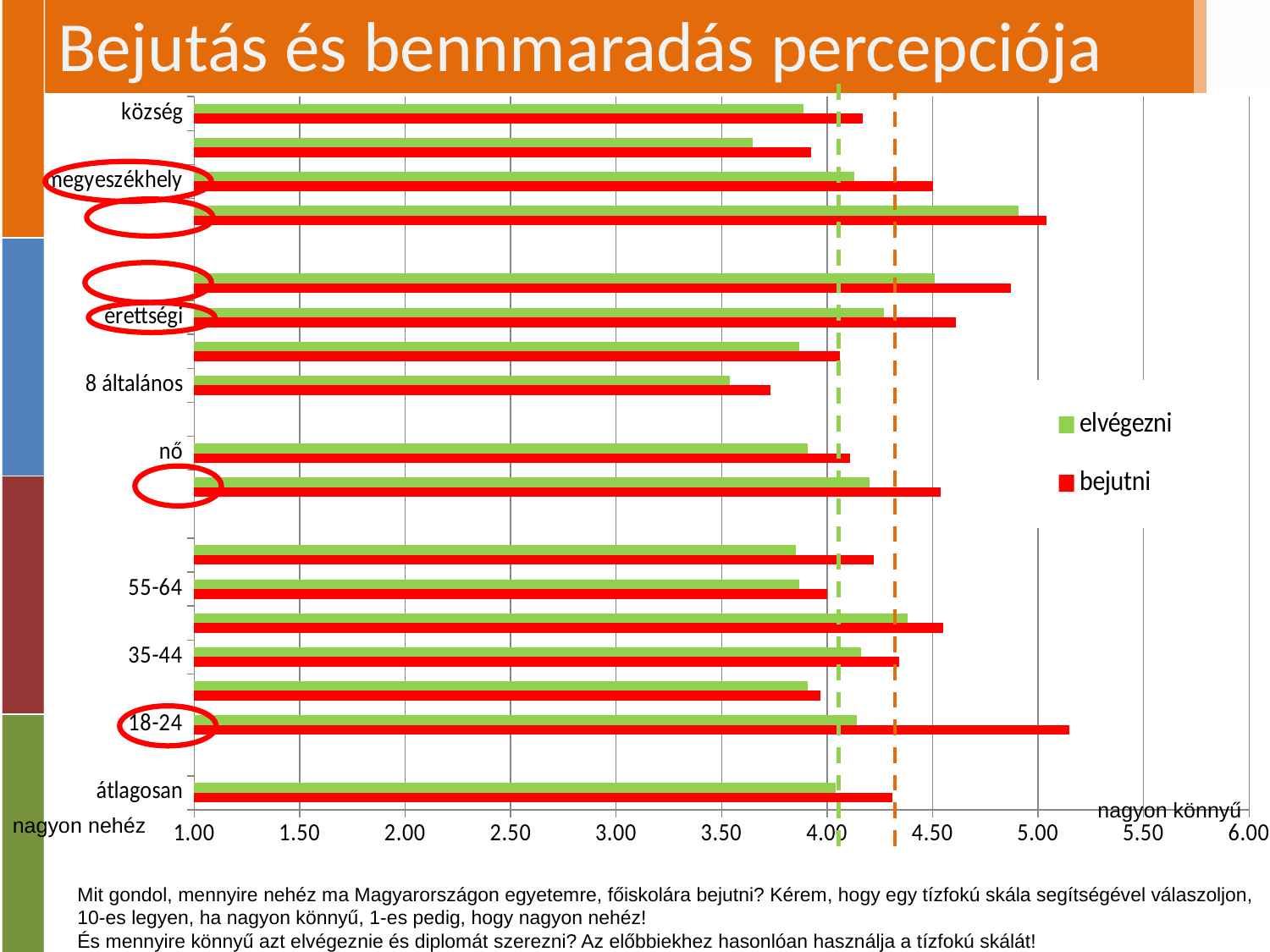
What is the title of the slide containing the chart? Bejutás és bennmaradás percepciója Is the elvégezni value for 8 általános greater or less than 4.00? less How many series does the chart legend list? 2 What kind of chart is shown on the slide? bar chart Is the bejutni value for 8 általános greater or less than 4.00? less What are the two series named in the chart legend? elvégezni and bejutni Among the labelled categories, which has the lowest elvégezni value? 8 általános Among the labelled categories, which has the highest bejutni value? 18-24 Is the elvégezni value for átlagosan greater or less than 4.50? less Among the labelled categories, which has the lowest bejutni value? 8 általános For the 18-24 category, which series has the larger value, bejutni or elvégezni? bejutni